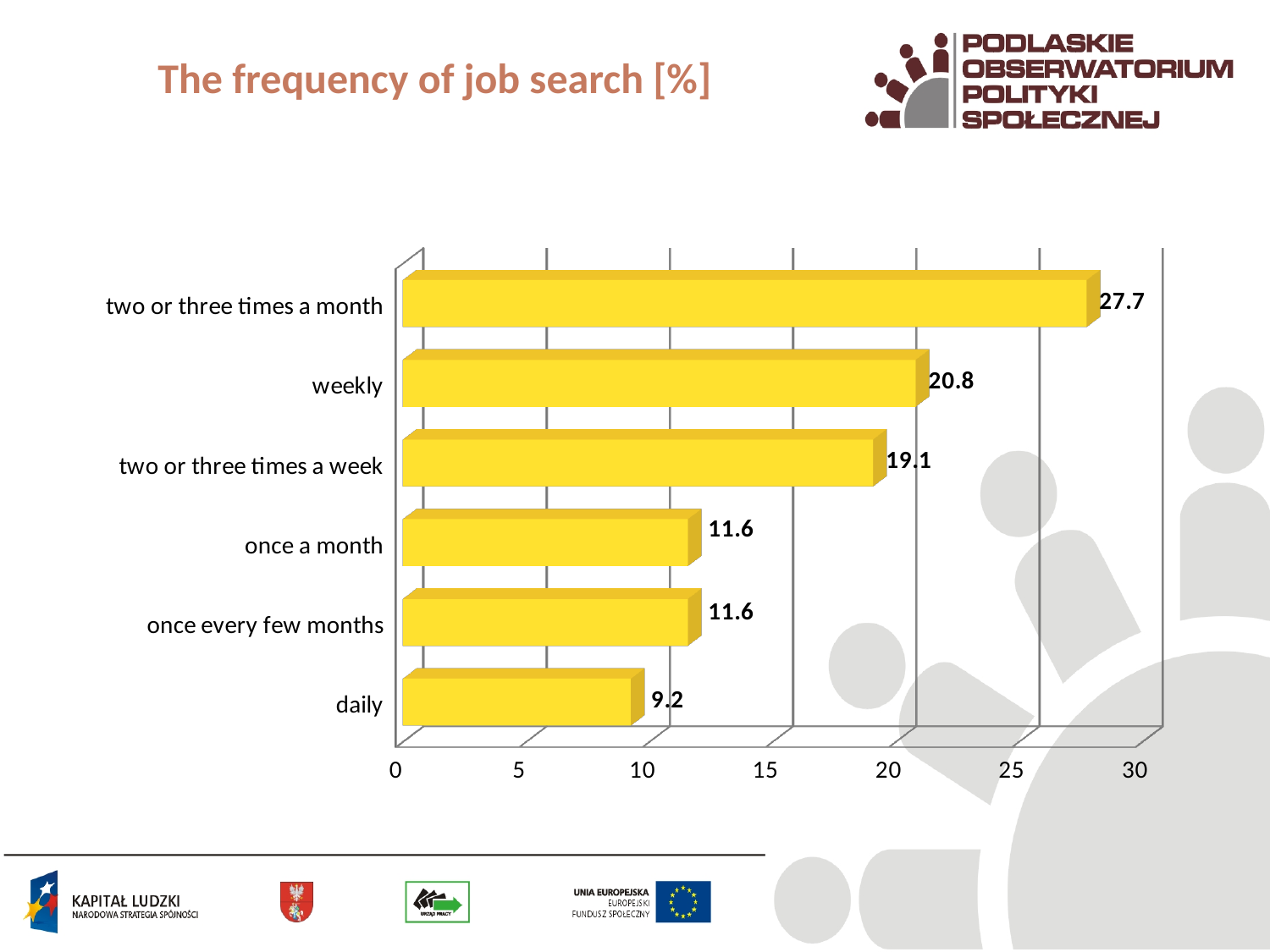
What is the value for 'two or three times a week'? 19.1 Which category has the highest value? two or three times a month Which category has the lowest value? daily What is the difference between the values for 'once a month' and 'daily'? 2.4 What kind of chart is shown on the slide? bar chart What is the value for 'weekly'? 20.8 Is the value for 'two or three times a month' greater or less than 25? greater Which is larger, the value for 'weekly' or the value for 'two or three times a week'? weekly What is the title of the chart? The frequency of job search [%] What is the difference between the values for 'two or three times a month' and 'weekly'? 6.9 How many categories are shown in the chart? 6 What is the value for 'daily'? 9.2